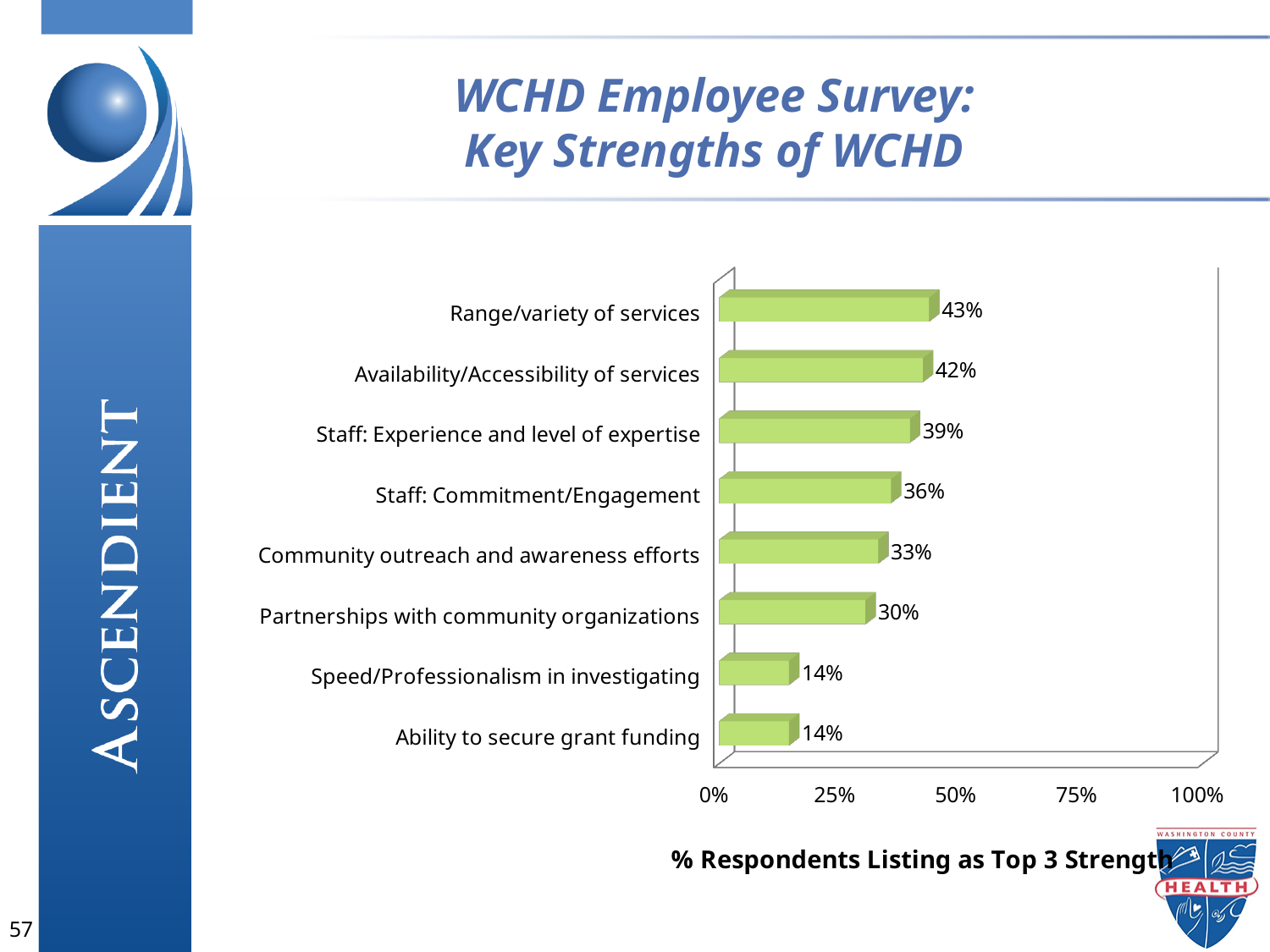
What is the difference between Staff: Experience and level of expertise and Community outreach and awareness efforts? 6% What is the label on the horizontal axis of the chart? % Respondents Listing as Top 3 Strength Which is larger, Availability/Accessibility of services or Staff: Commitment/Engagement? Availability/Accessibility of services What kind of chart is shown on the slide? Bar chart What is the value for Speed/Professionalism in investigating? 14% How many categories are shown in the chart? 8 What is the difference between Range/variety of services and Ability to secure grant funding? 29% What is the value for Partnerships with community organizations? 30% What is the value for Staff: Commitment/Engagement? 36% Which category has the highest value? Range/variety of services What percentage of respondents listed Range/variety of services as a top 3 strength? 43% Is the value for Community outreach and awareness efforts greater or less than 50%? less